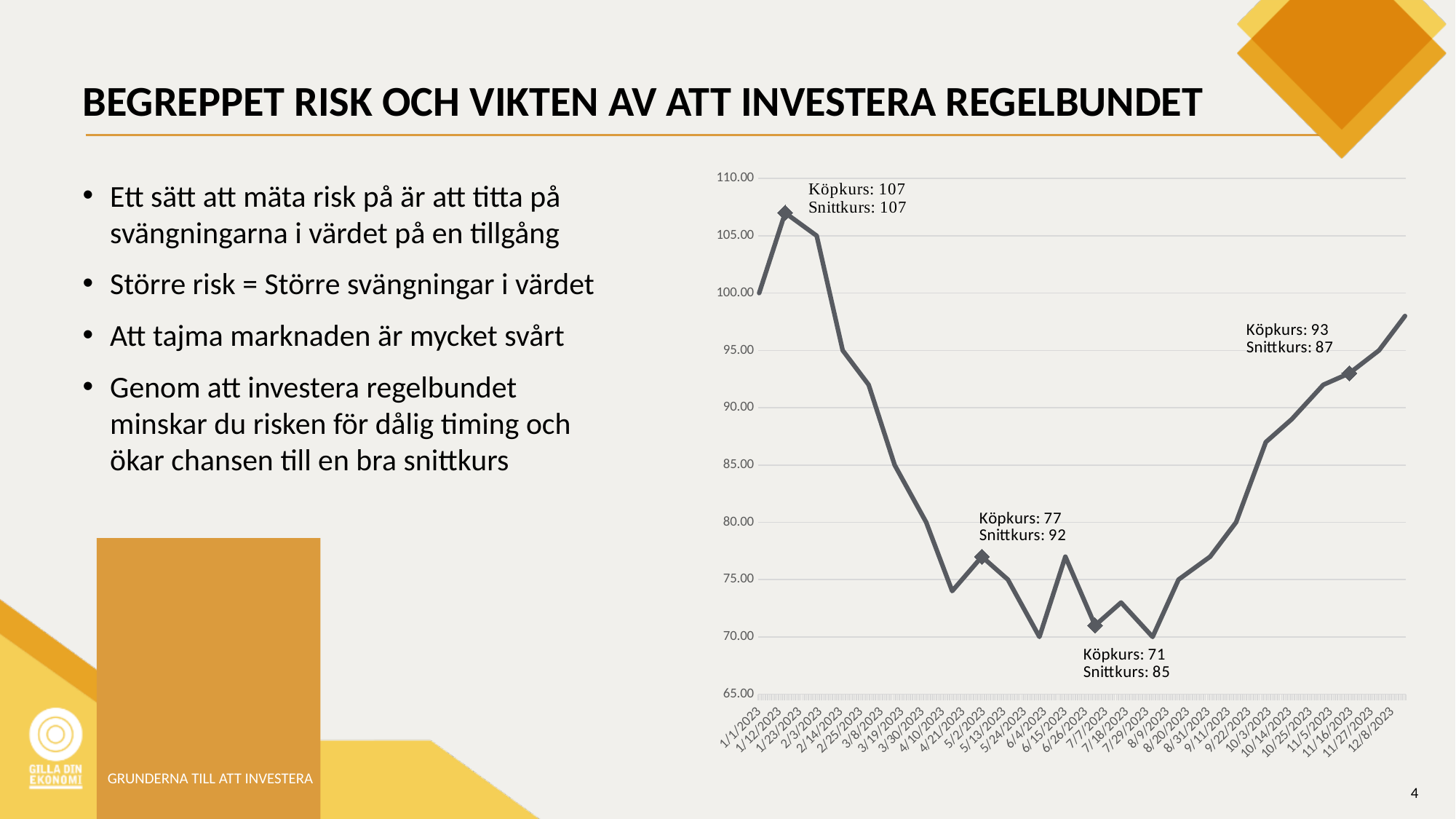
What is the difference between the highest annotated Köpkurs (107) and the lowest annotated Köpkurs (71)? 36 What is the Köpkurs at the first annotated point on the chart? 107 Does the line rise or fall between 8/9/2023 and 12/8/2023? rise Which annotated point has the lowest Köpkurs? Köpkurs: 71 How many date labels are shown on the x axis? 32 What is the Snittkurs at the annotated point where Köpkurs is 77? 92 Is the value at 8/9/2023 greater or less than 75? less What is the Snittkurs at the annotated point where Köpkurs is 71? 85 What kind of chart is shown on the slide? line chart What is the Köpkurs at the last annotated point on the chart? 93 Is the value at 12/8/2023 greater or less than 95? greater At the last annotated point, which is larger: the Köpkurs or the Snittkurs? Köpkurs